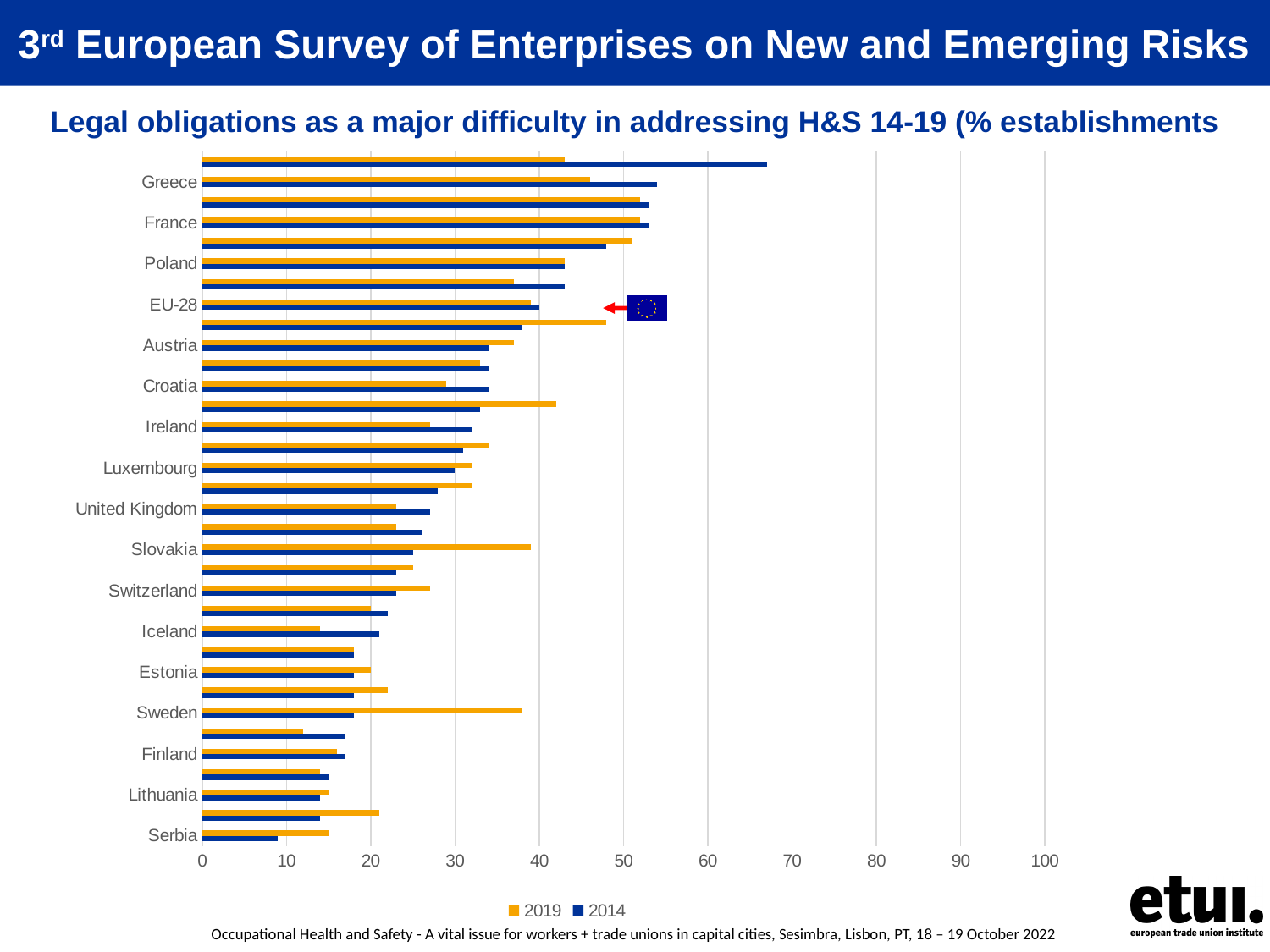
For Greece, which is larger: the 2019 value or the 2014 value? 2014 How many series does the legend list? 2 Which labelled country has the lowest 2014 value? Serbia For Slovakia, which is larger: the 2019 value or the 2014 value? 2019 Is the 2019 value for Sweden greater or less than 30? greater Is the 2014 value for Greece greater or less than 50? greater What kind of chart is shown on the slide? bar chart Which colour represents the 2014 series? blue Is the 2019 value for EU-28 greater or less than 50? less Which years are listed in the legend? 2019 and 2014